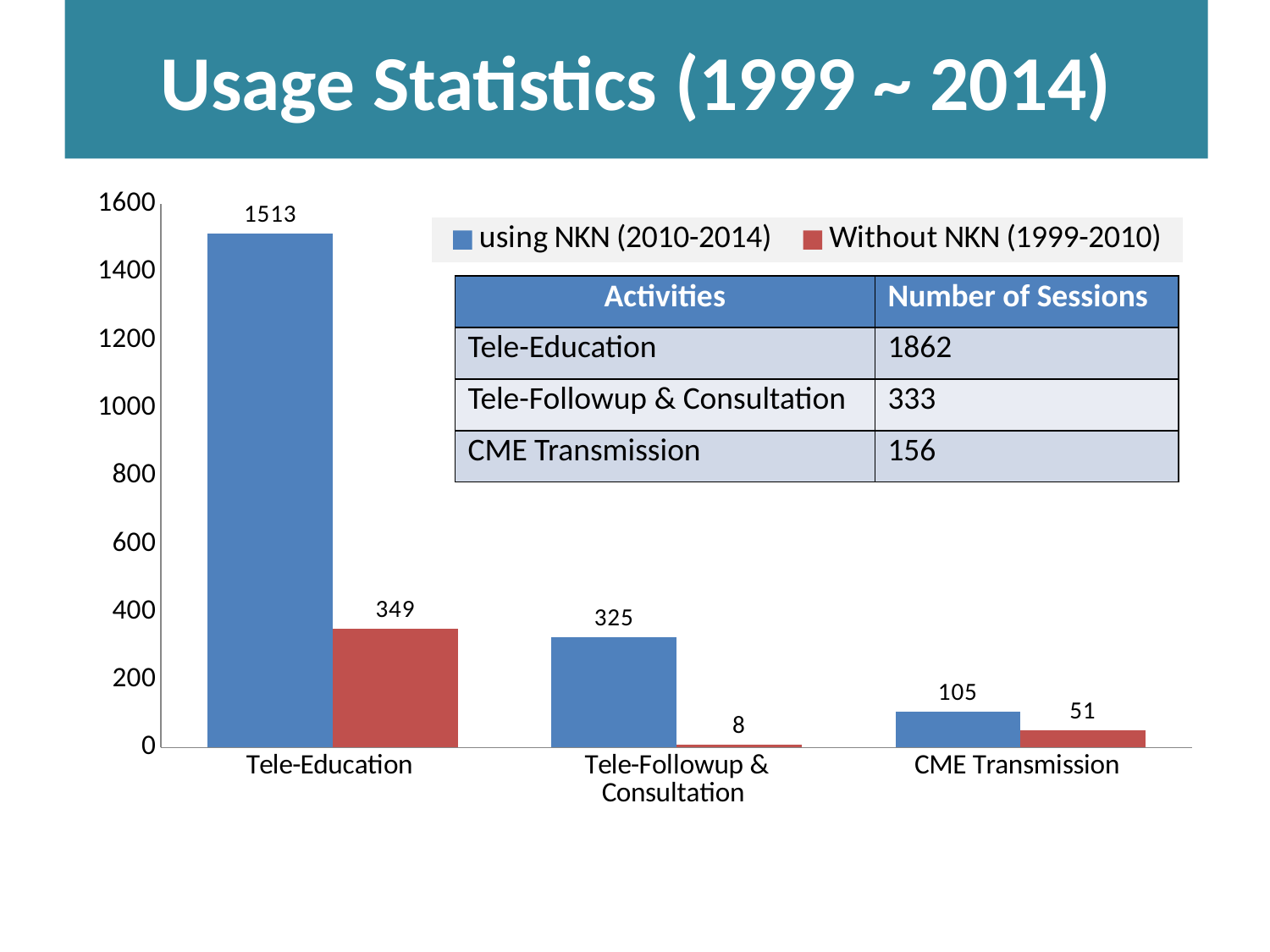
What kind of chart is shown on the slide? Bar chart How many categories are shown on the x axis of the chart? 3 What is the value for CME Transmission in the 'using NKN (2010-2014)' series? 105 Which is larger: the 'Without NKN (1999-2010)' value for Tele-Education or the 'using NKN (2010-2014)' value for Tele-Followup & Consultation? Without NKN (1999-2010) value for Tele-Education What is the difference between the 'using NKN (2010-2014)' and 'Without NKN (1999-2010)' values for Tele-Education? 1164 What colour represents the 'Without NKN (1999-2010)' series in the chart? Red What is the value for Tele-Education in the 'using NKN (2010-2014)' series? 1513 Which category has the highest value in the 'using NKN (2010-2014)' series? Tele-Education How many series does the chart legend list? 2 What is the value for Tele-Followup & Consultation in the 'Without NKN (1999-2010)' series? 8 Which category has the lowest value in the 'Without NKN (1999-2010)' series? Tele-Followup & Consultation What is the difference between the 'using NKN (2010-2014)' and 'Without NKN (1999-2010)' values for CME Transmission? 54